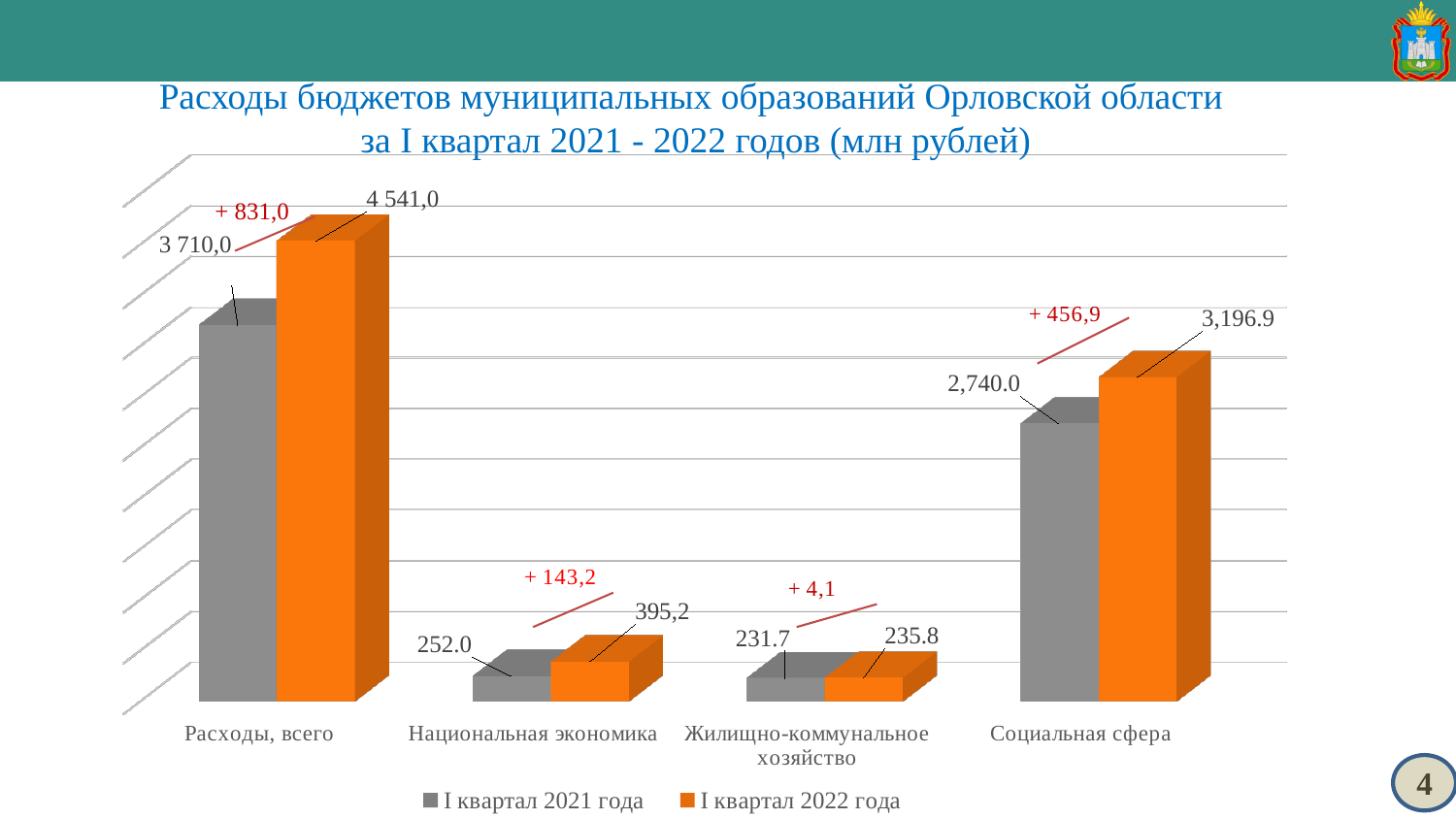
What is the value for «Социальная сфера» in the «I квартал 2021 года» series? 2,740.0 What kind of chart is shown on the slide? Bar chart What is the value for «Расходы, всего» in the «I квартал 2022 года» series? 4 541,0 What is the increase shown for «Социальная сфера» between I квартал 2021 года and I квартал 2022 года? + 456,9 How many series does the legend list? 2 What is the value for «Национальная экономика» in the «I квартал 2022 года» series? 395,2 Which category has the lowest value in the «I квартал 2022 года» series? Жилищно-коммунальное хозяйство Which is larger for «Национальная экономика»: the I квартал 2021 года value or the I квартал 2022 года value? I квартал 2022 года What is the value for «Жилищно-коммунальное хозяйство» in the «I квартал 2021 года» series? 231.7 What is the value for «Расходы, всего» in the «I квартал 2021 года» series? 3 710,0 How many categories are shown on the x axis of the chart? 4 Which category has the highest value in the «I квартал 2021 года» series? Расходы, всего